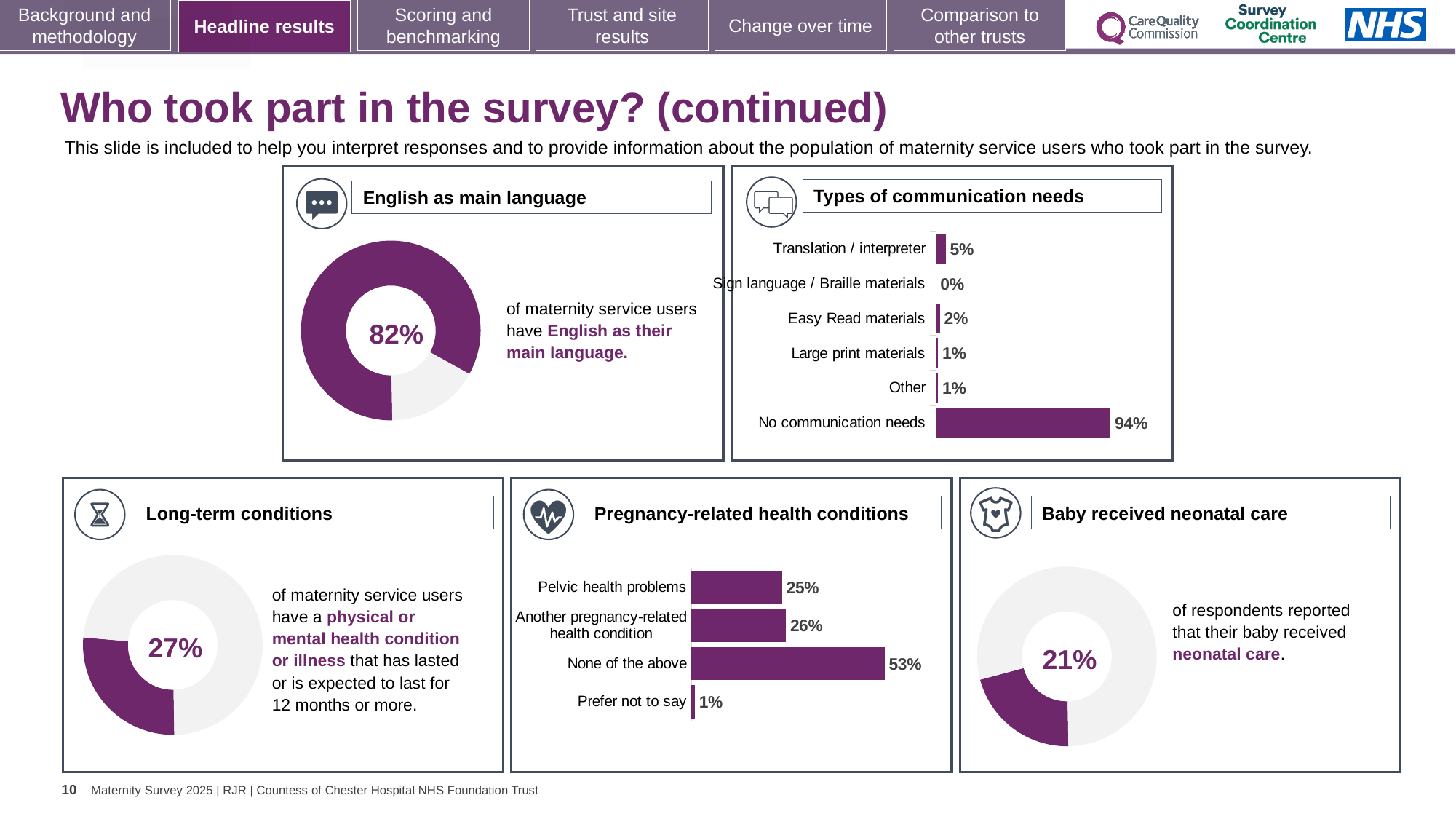
What percentage is shown in the 'Long-term conditions' chart? 27% In the 'Types of communication needs' chart, what is the value for Translation / interpreter? 5% In the 'Pregnancy-related health conditions' chart, what is the difference between None of the above and Pelvic health problems? 28% In the 'Types of communication needs' chart, what is the difference between No communication needs and Translation / interpreter? 89% In the 'Types of communication needs' chart, which category has the highest value? No communication needs In the 'Types of communication needs' chart, how many categories are shown? 6 In the 'Pregnancy-related health conditions' chart, which is larger: Pelvic health problems or Another pregnancy-related health condition? Another pregnancy-related health condition What kind of chart is the 'Types of communication needs' chart? Bar chart What percentage is shown in the 'Baby received neonatal care' chart? 21% In the 'Pregnancy-related health conditions' chart, what is the value for None of the above? 53% In the 'Pregnancy-related health conditions' chart, which category has the lowest value? Prefer not to say What percentage is shown in the 'English as main language' chart? 82%